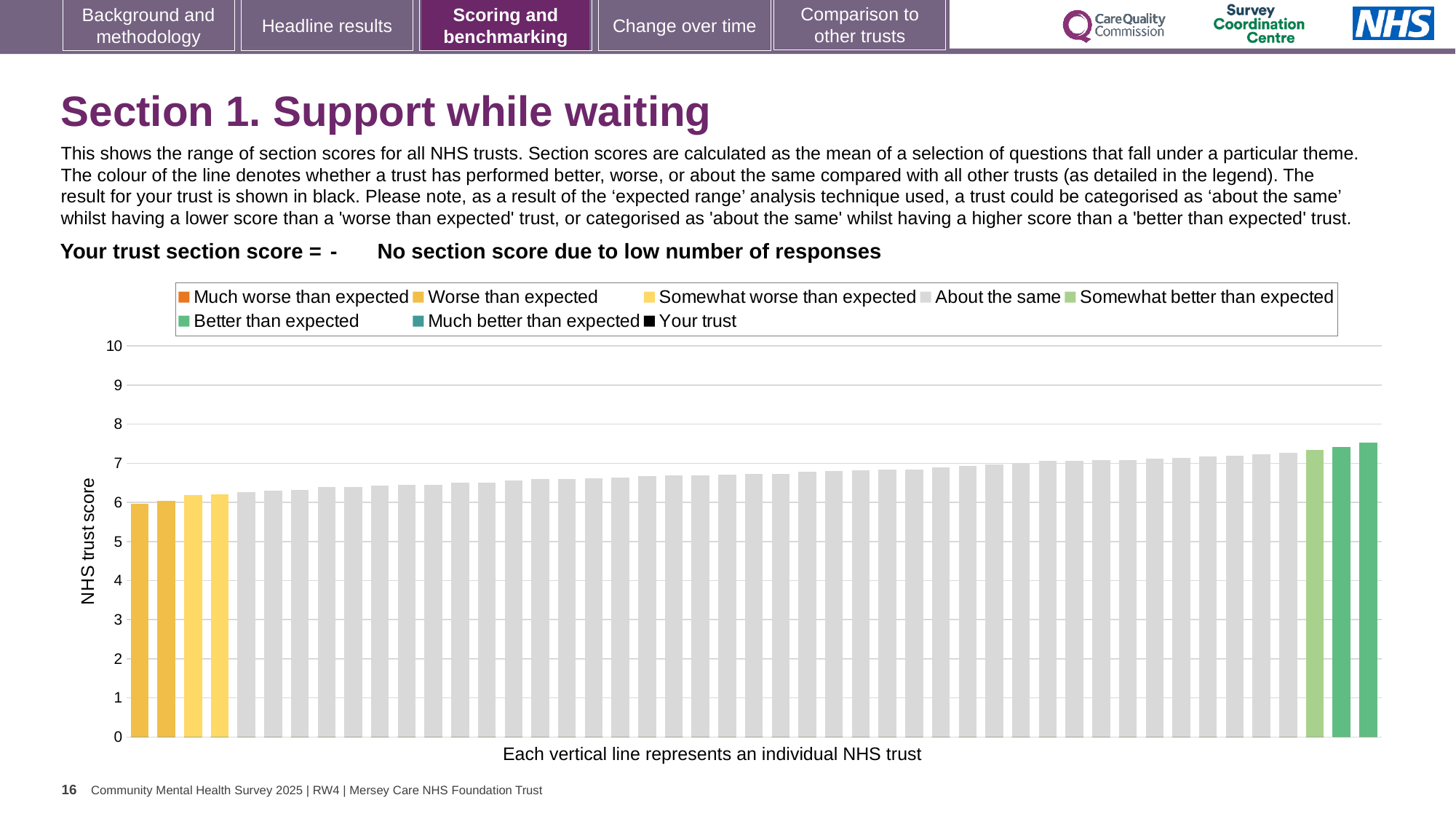
Is the value of the shortest bar (leftmost) greater or less than 5? greater Is the value of the tallest bar greater or less than 8? less What does each vertical line in the chart represent, according to the x-axis label? an individual NHS trust Is the value of the shortest bar greater or less than 7? less Which bar is taller, the leftmost bar or the rightmost bar? the rightmost bar Do the bar values rise or fall from left to right across the chart? rise What is the label on the vertical axis of the chart? NHS trust score How many entries does the chart legend list? 8 What kind of chart is shown on the slide? bar chart What is the maximum value shown on the vertical axis? 10